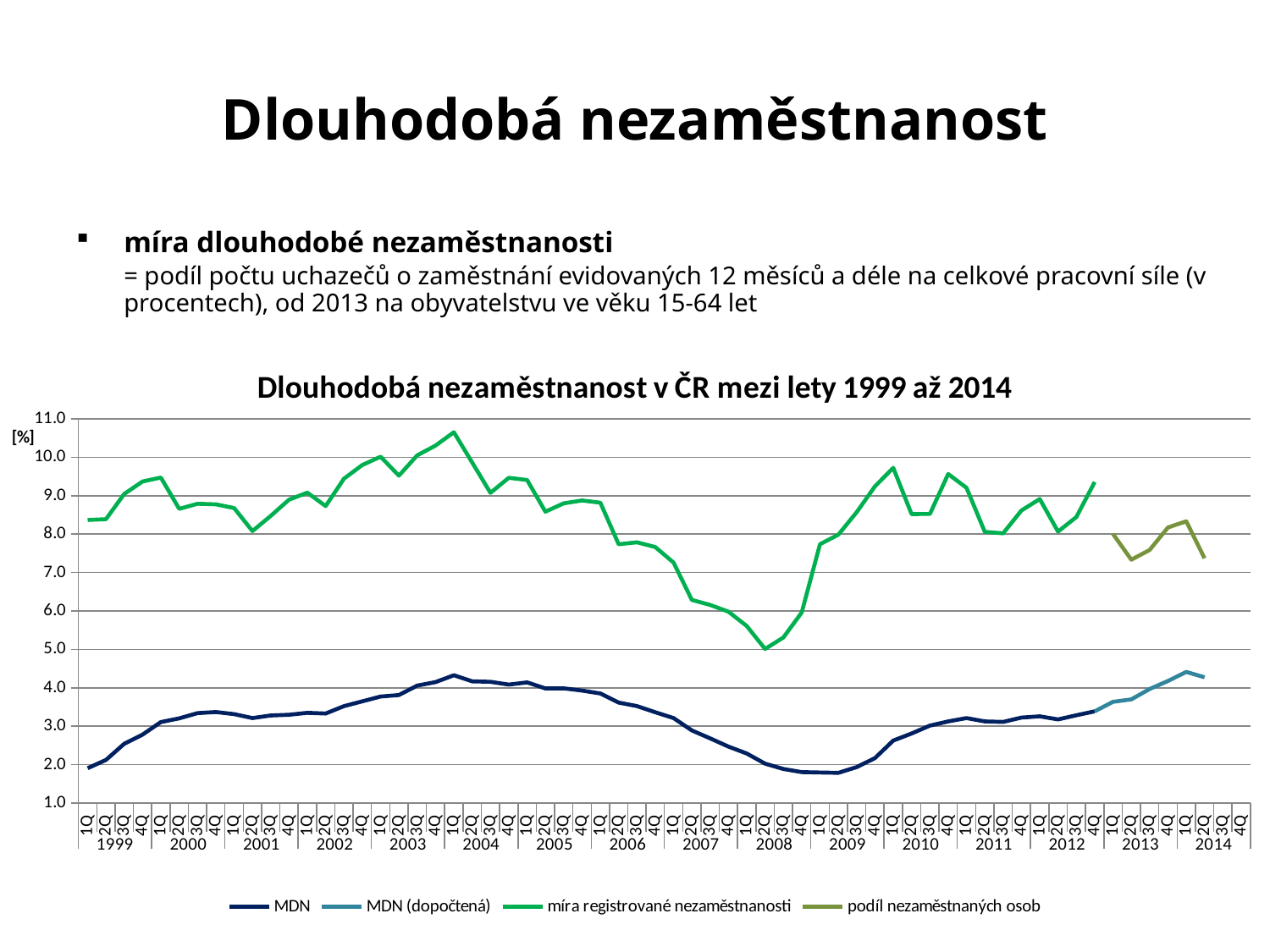
Is the value of míra registrované nezaměstnanosti in 1Q 2004 greater or less than 10.0? greater How many series does the chart legend list? 4 Is the value of MDN (dopočtená) in 1Q 2014 greater or less than 4.0? greater What kind of chart is shown on the slide? line chart What is the title of the chart? Dlouhodobá nezaměstnanost v ČR mezi lety 1999 až 2014 Is the value of podíl nezaměstnaných osob in 2Q 2013 greater or less than 8.0? less Does the míra registrované nezaměstnanosti series rise or fall between 1Q 2004 and 2Q 2008? fall Does the MDN series rise or fall between 1Q 1999 and 1Q 2004? rise Which series is drawn in green in the chart? míra registrované nezaměstnanosti In which quarter does the míra registrované nezaměstnanosti series reach its lowest value? 2Q 2008